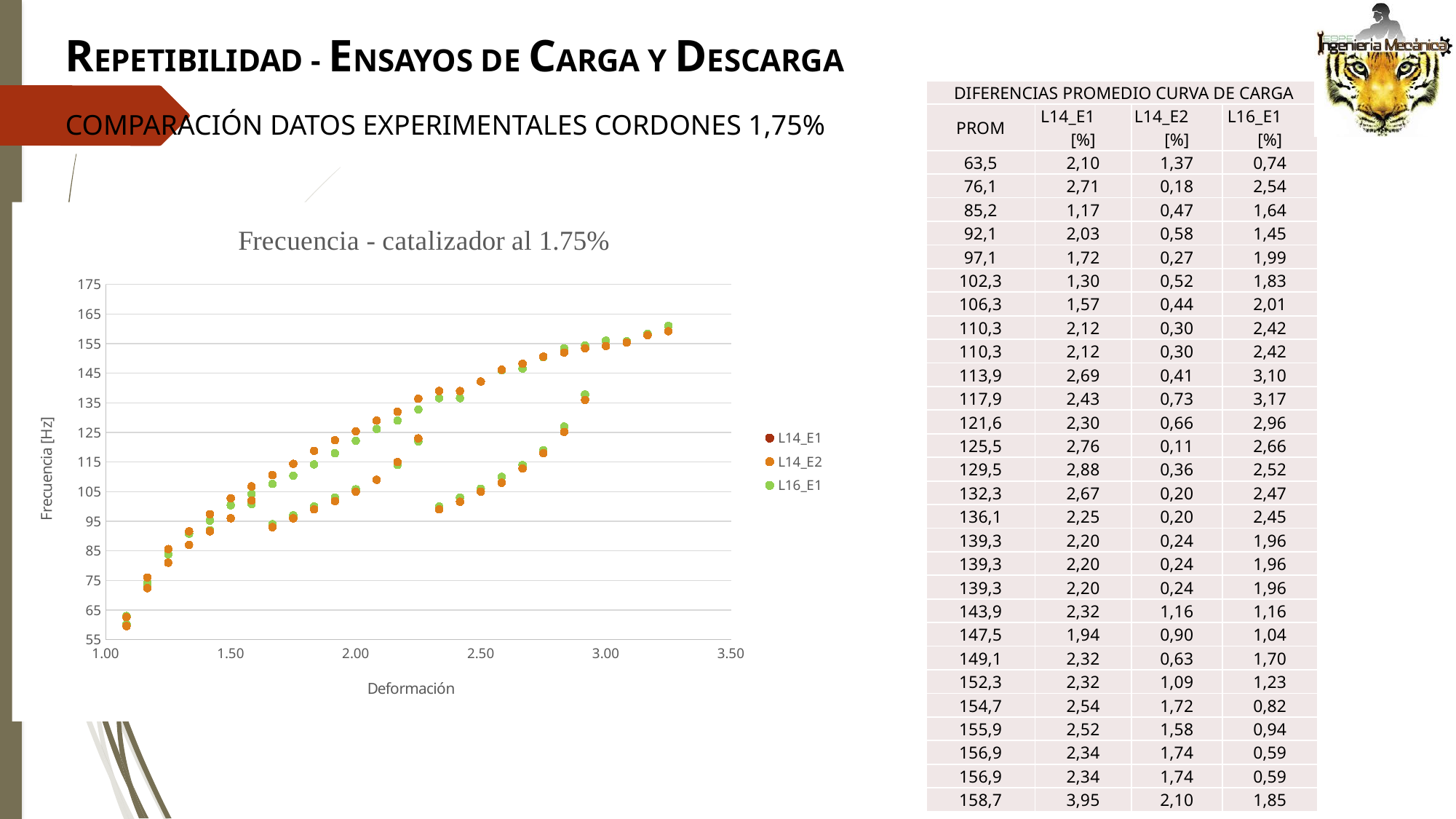
Is the highest plotted frequency value in the chart greater or less than 155? greater What is the label of the horizontal axis of the chart? Deformación What is the title of the chart? Frecuencia - catalizador al 1.75% What is the label of the vertical axis of the chart? Frecuencia [Hz] What is the maximum value shown on the vertical axis of the chart? 175 What is the maximum value shown on the horizontal axis of the chart? 3.50 How many series does the legend of the chart list? 3 Is the frequency value of the points plotted at Deformación 3.00 greater or less than 145? greater What are the names of the series listed in the chart legend? L14_E1, L14_E2, L16_E1 What kind of chart is shown on the slide? scatter chart Do the frequency values generally rise or fall as Deformación increases along the x axis? rise Is the lowest plotted frequency value in the chart greater or less than 65? less